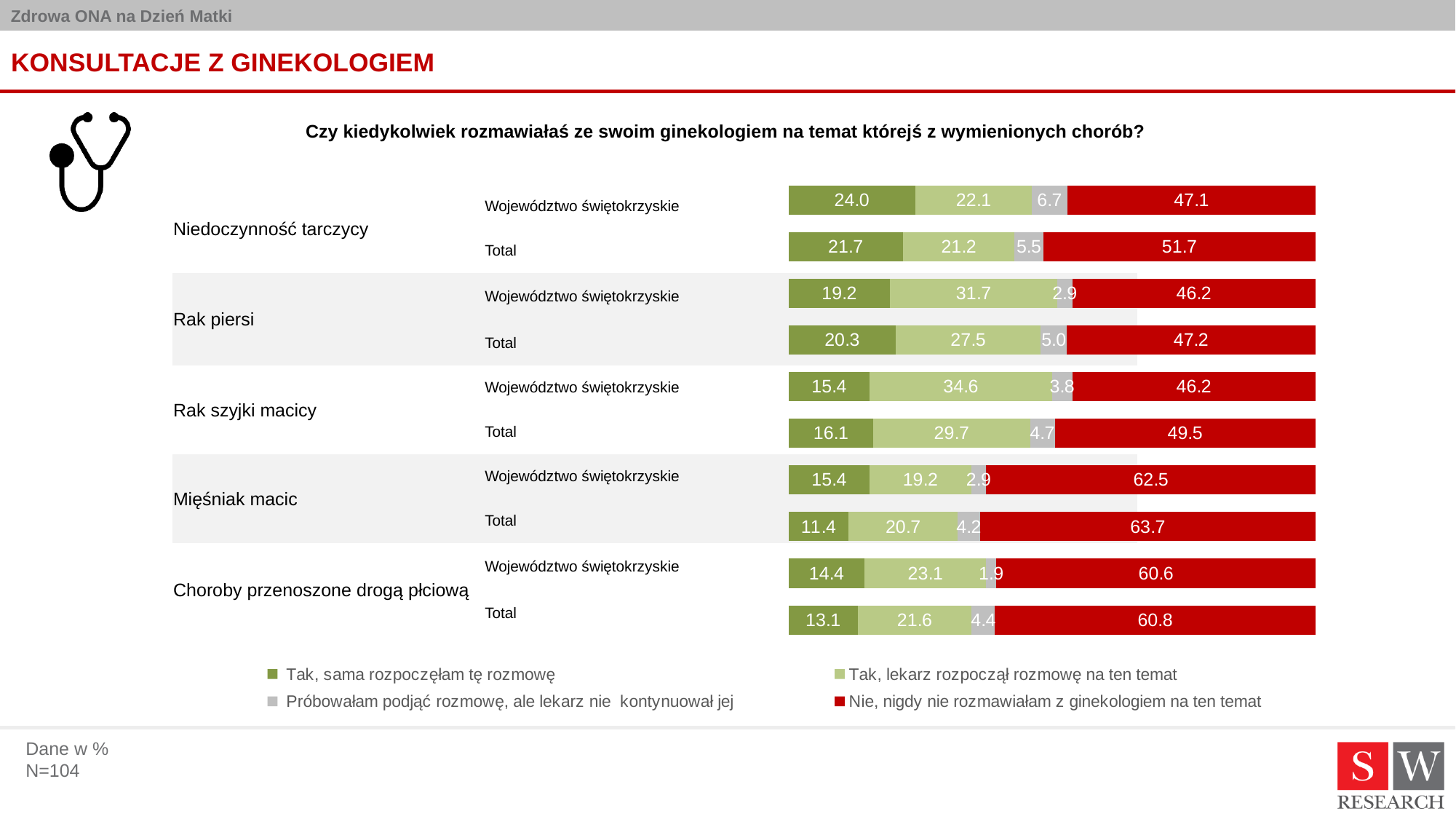
What is the total of the stacked bar for Rak piersi in Województwo świętokrzyskie? 100.0 What is the value for "Tak, lekarz rozpoczął rozmowę na ten temat" for Rak szyjki macicy in Województwo świętokrzyskie? 34.6 How many bars are shown in the chart? 10 Which bar has the lowest value for "Tak, sama rozpoczęłam tę rozmowę"? Mięśniak macic, Total How many series does the legend list? 4 What is the difference between the "Nie, nigdy nie rozmawiałam" values for Mięśniak macic and Rak piersi in Województwo świętokrzyskie? 16.3 Which is larger for Rak piersi: the "Tak, lekarz rozpoczął rozmowę" value for Województwo świętokrzyskie or for Total? Województwo świętokrzyskie What is the value for "Nie, nigdy nie rozmawiałam z ginekologiem na ten temat" for Mięśniak macic in the Total row? 63.7 What is the value for "Tak, sama rozpoczęłam tę rozmowę" for Niedoczynność tarczycy in Województwo świętokrzyskie? 24.0 Which bar has the highest value for "Nie, nigdy nie rozmawiałam z ginekologiem na ten temat"? Mięśniak macic, Total What kind of chart is shown on the slide? Stacked bar chart What is the value for "Próbowałam podjąć rozmowę, ale lekarz nie kontynuował jej" for Choroby przenoszone drogą płciową in Województwo świętokrzyskie? 1.9